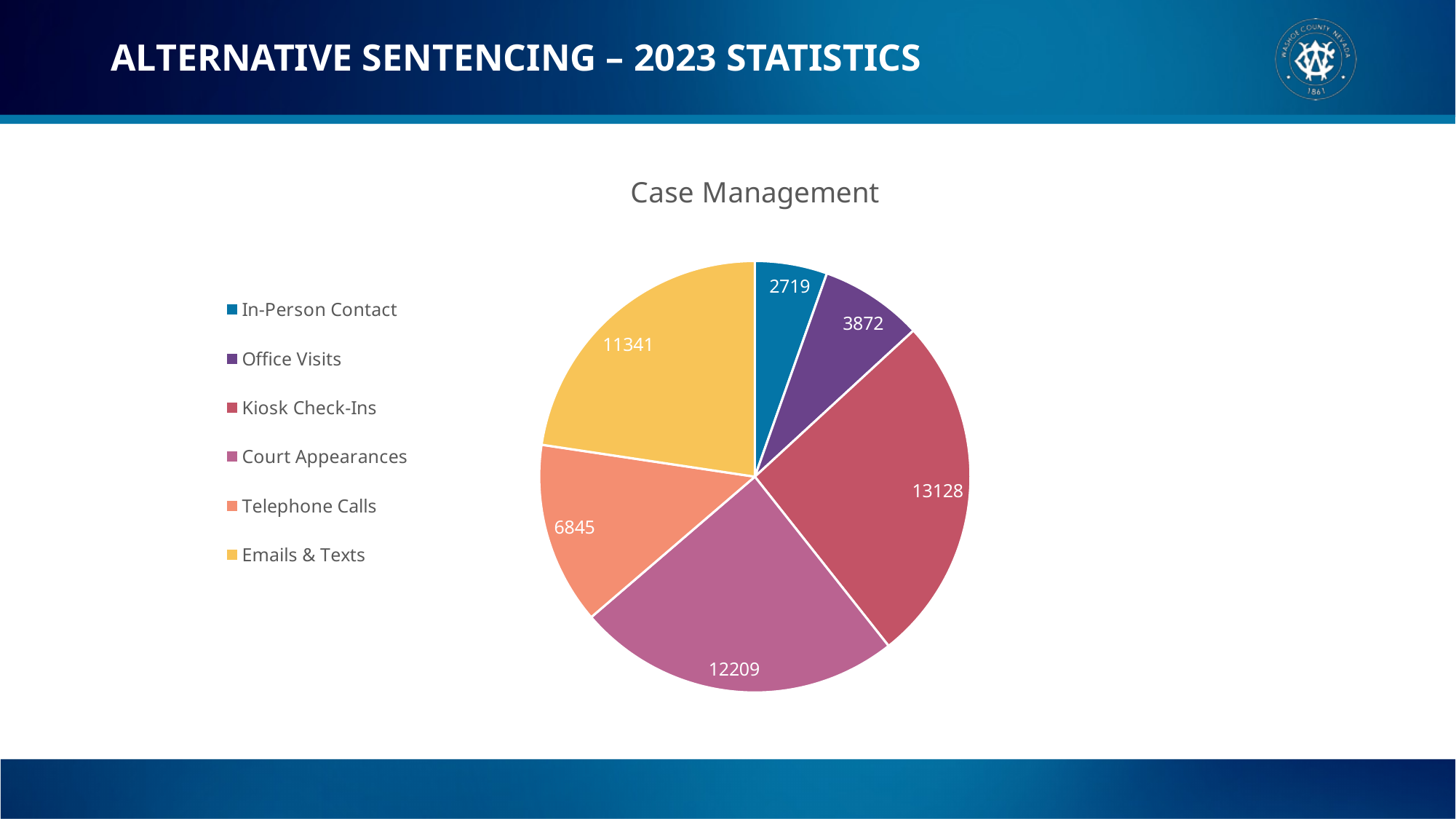
Which is larger, Emails & Texts or Telephone Calls? Emails & Texts What is the value for Emails & Texts? 11341 What is the value for Telephone Calls? 6845 Which category has the largest slice? Kiosk Check-Ins How many categories does the pie chart have? 6 What is the value for In-Person Contact? 2719 What is the difference between Office Visits and In-Person Contact? 1153 What is the difference between Kiosk Check-Ins and Court Appearances? 919 What is the title of the chart? Case Management Which category has the smallest slice? In-Person Contact What is the value for Kiosk Check-Ins? 13128 What type of chart is shown on the slide? Pie chart